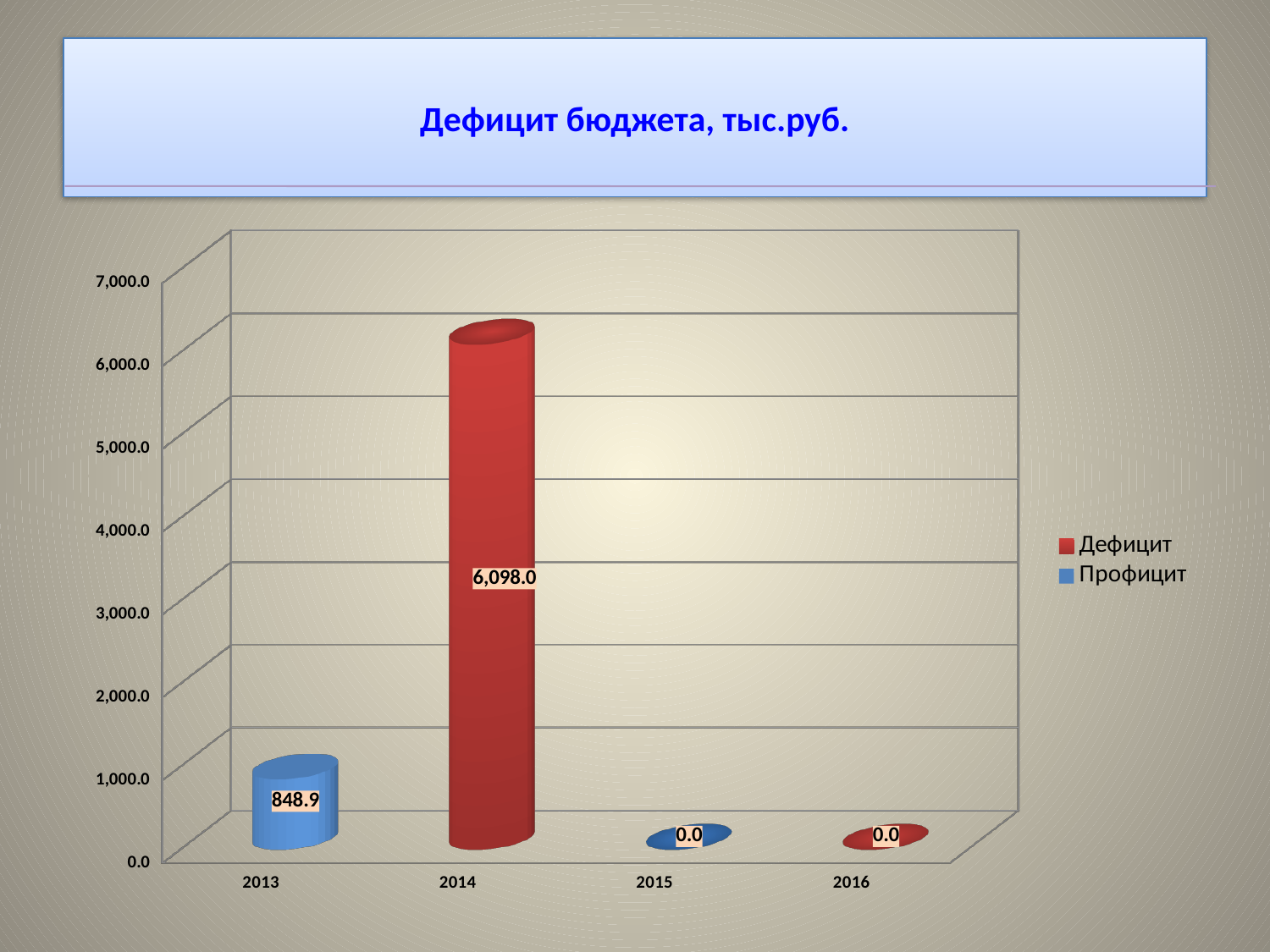
How many years are shown on the x axis? 4 Is the value for 2013 greater or less than 1,000.0? less Which year has the highest value on the chart? 2014 What is the value shown for 2013? 848.9 What is the title of the chart? Дефицит бюджета, тыс.руб. What is the difference between the values for 2014 and 2013? 5,249.1 What is the value shown for 2014? 6,098.0 Which is larger, the value for 2013 or the value for 2014? 2014 What is the value shown for 2016? 0.0 How many series does the legend list? 2 Is the value for 2014 greater or less than 6,000.0? greater What is the value shown for 2015? 0.0